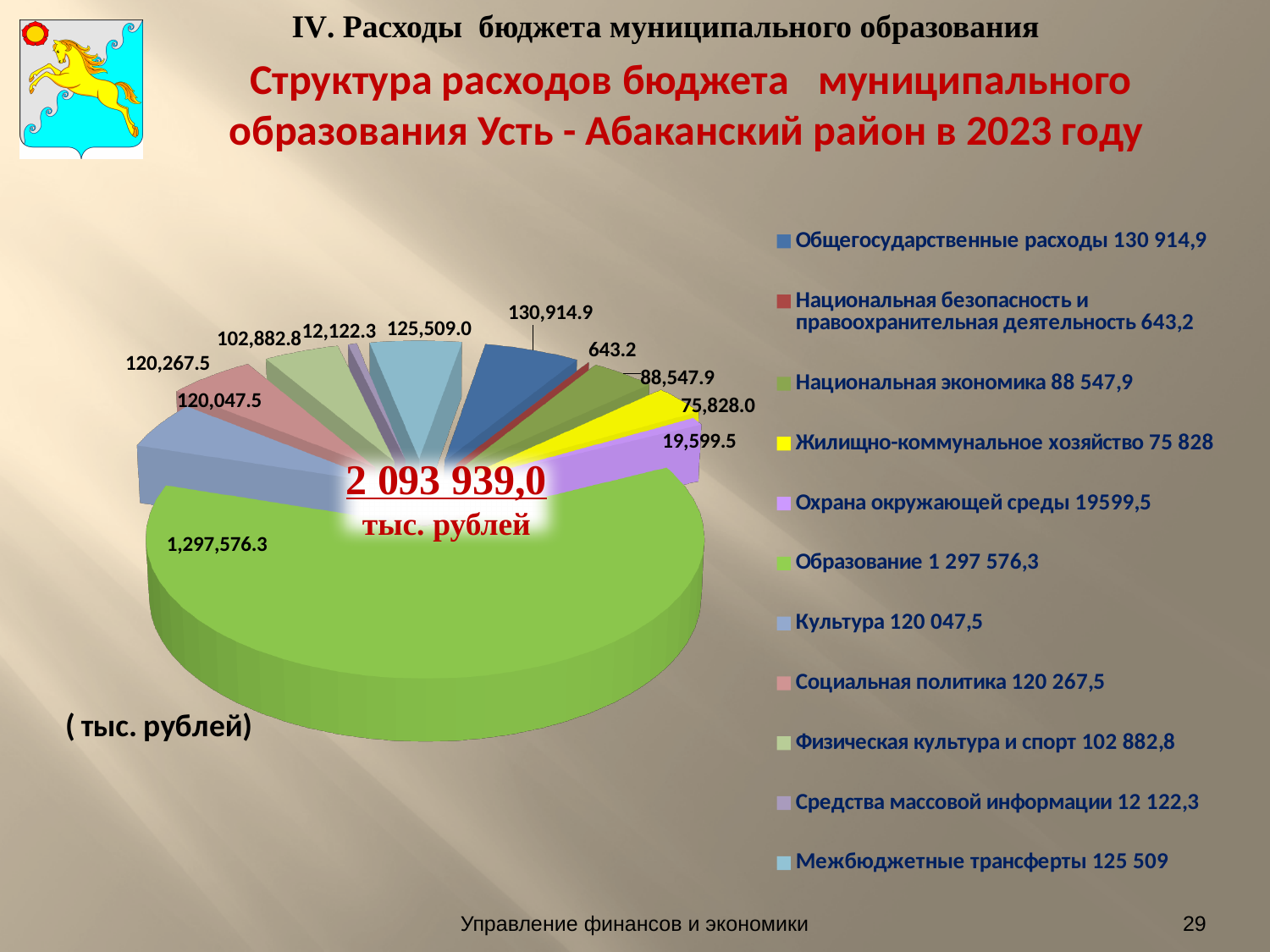
Which category has the largest slice of the pie chart? Образование What type of chart is shown on the slide? Pie chart What is the value for Охрана окружающей среды on the pie chart? 19,599.5 How many categories are shown in the pie chart? 11 What is the difference between the values for Общегосударственные расходы and Межбюджетные трансферты? 5,405.9 What is the value for Межбюджетные трансферты on the pie chart? 125,509.0 What total value is printed in the centre of the pie chart? 2 093 939,0 тыс. рублей What is the value for Образование on the pie chart? 1,297,576.3 Which category has the smallest slice of the pie chart? Национальная безопасность и правоохранительная деятельность What is the value for Национальная экономика on the pie chart? 88,547.9 Which is larger: Жилищно-коммунальное хозяйство or Национальная экономика? Национальная экономика What is the difference between the values for Социальная политика and Культура? 220.0